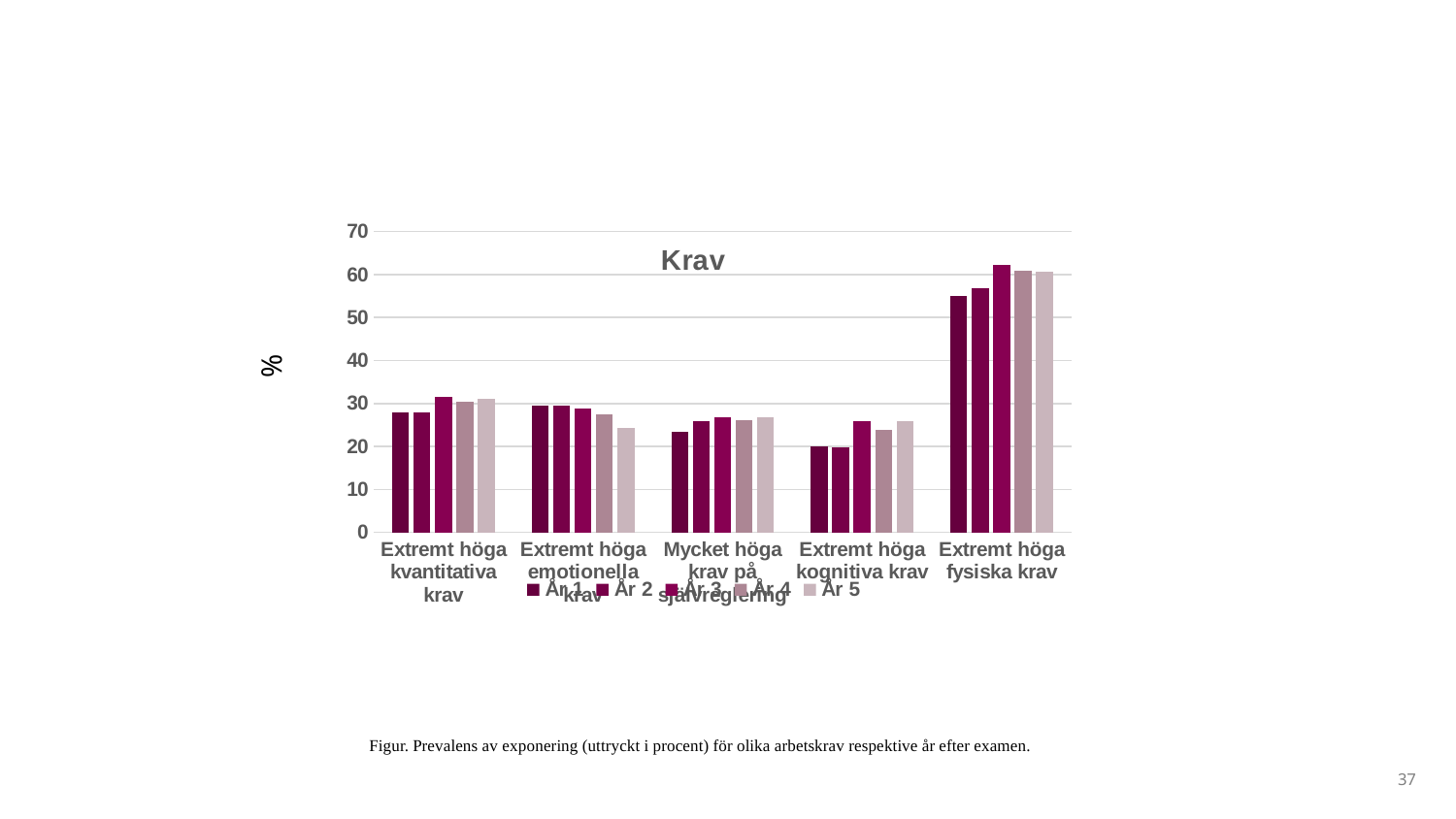
How many series does the legend list? 5 What kind of chart is shown on the slide? bar chart Is the value for År 1 in Extremt höga fysiska krav greater or less than 60? less Which category has the highest values across all years? Extremt höga fysiska krav Is the value for År 5 in Extremt höga emotionella krav greater or less than 30? less What is the label on the y axis? % How many categories are shown on the x axis? 5 Is the value for År 3 in Extremt höga fysiska krav greater or less than 60? greater In Extremt höga kognitiva krav, which is larger: the value for År 1 or År 3? År 3 In Extremt höga emotionella krav, which is larger: the value for År 1 or År 5? År 1 What is the title of the chart? Krav Which category has the lowest value for År 1? Extremt höga kognitiva krav